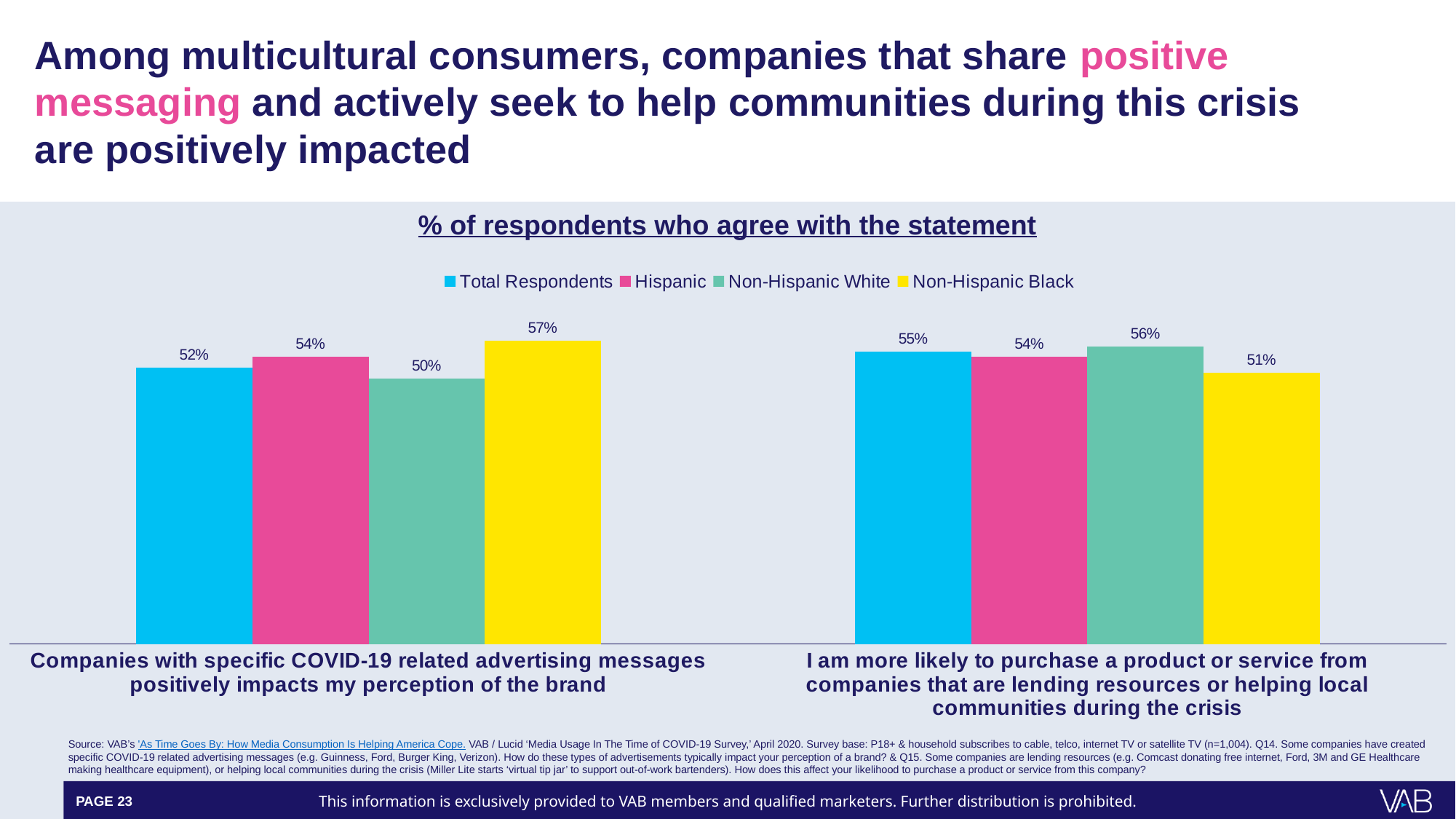
What is the title of the chart? % of respondents who agree with the statement Which group has the lowest share agreeing they are more likely to purchase from companies lending resources or helping local communities? Non-Hispanic Black What is the difference between Non-Hispanic White and Non-Hispanic Black respondents on the statement about being more likely to purchase from companies helping local communities? 5 percentage points What kind of chart is shown on the slide? Bar chart What is the difference between Non-Hispanic Black and Non-Hispanic White respondents on the statement about COVID-19 related advertising messages positively impacting brand perception? 7 percentage points Which group has the highest share agreeing that COVID-19 related advertising messages positively impact their perception of the brand? Non-Hispanic Black How many series does the legend list? 4 What percentage of Hispanic respondents agree that companies with specific COVID-19 related advertising messages positively impact their perception of the brand? 54% Which group has the lowest share agreeing that COVID-19 related advertising messages positively impact their perception of the brand? Non-Hispanic White For Non-Hispanic White respondents, which statement has the higher agreement: the one about COVID-19 related advertising messages or the one about purchasing from companies helping local communities? Purchasing from companies helping local communities What percentage of Non-Hispanic Black respondents agree they are more likely to purchase from companies lending resources or helping local communities during the crisis? 51% What is the value for Total Respondents on the statement about being more likely to purchase from companies helping local communities? 55%